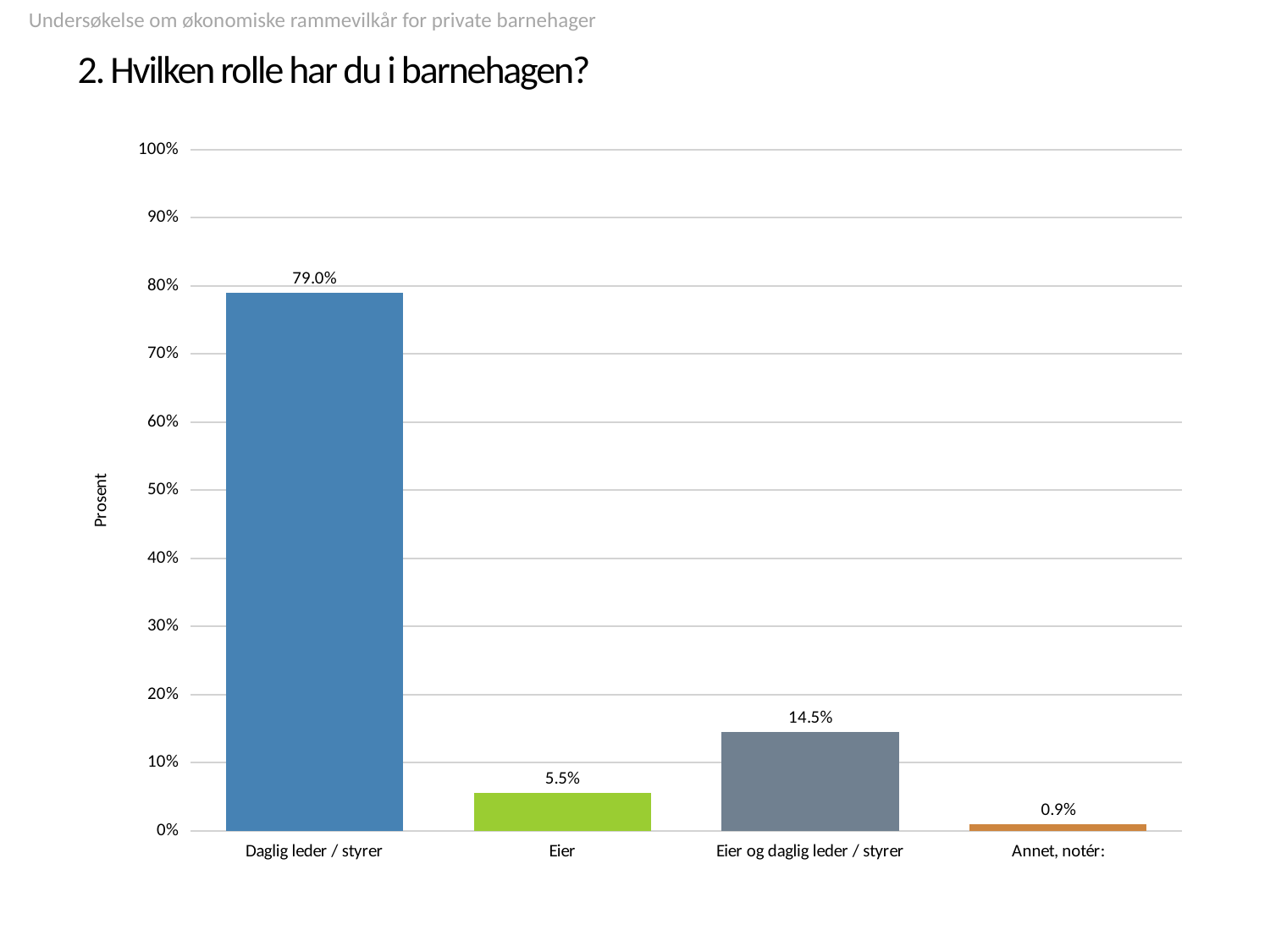
What is the difference between the values for Daglig leder / styrer and Eier og daglig leder / styrer? 64.5% Which is larger, the value for Eier or the value for Eier og daglig leder / styrer? Eier og daglig leder / styrer How many categories are shown on the x axis? 4 What is the value for Eier og daglig leder / styrer? 14.5% Which category has the highest value? Daglig leder / styrer Which category has the lowest value? Annet, notér: What is the value for Annet, notér:? 0.9% What is the label of the y axis? Prosent What is the value for Daglig leder / styrer? 79.0% What is the value for Eier? 5.5% What is the difference between the values for Eier og daglig leder / styrer and Eier? 9.0% What kind of chart is shown on the slide? Bar chart